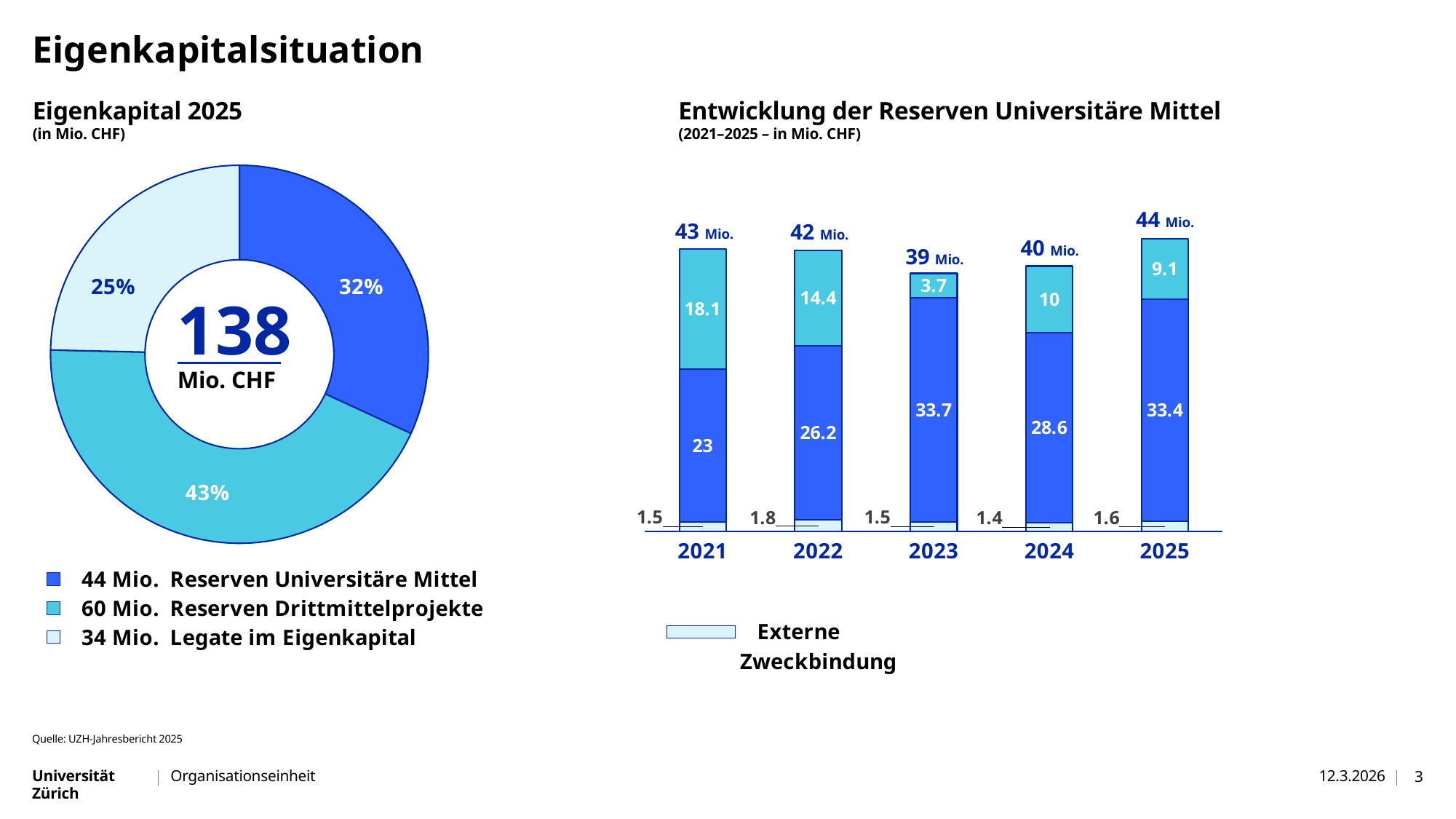
In the 'Entwicklung der Reserven Universitäre Mittel' chart, is the top (cyan) segment larger in 2021 or in 2025? 2021 What kind of chart is 'Eigenkapital 2025'? Pie (donut) chart In the 'Entwicklung der Reserven Universitäre Mittel' chart, what is the total shown above the bar for 2023? 39 Mio. In the 'Entwicklung der Reserven Universitäre Mittel' chart, which year has the highest total? 2025 In the 'Eigenkapital 2025' donut chart, how many categories does the legend list? 3 In the 'Eigenkapital 2025' donut chart, what share is labelled for Reserven Drittmittelprojekte? 43% In the 'Eigenkapital 2025' donut chart, which category has the smallest share? Legate im Eigenkapital In the 'Entwicklung der Reserven Universitäre Mittel' chart, what is the value of the light-blue 'Externe Zweckbindung' segment for 2022? 1.8 What kind of chart is 'Entwicklung der Reserven Universitäre Mittel'? Stacked bar chart In the 'Eigenkapital 2025' donut chart, what amount does the legend give for Reserven Universitäre Mittel? 44 Mio. In the 'Entwicklung der Reserven Universitäre Mittel' chart, what is the difference between the totals for 2025 and 2023? 5 Mio. In the 'Eigenkapital 2025' donut chart, what total value is shown in the centre? 138 Mio. CHF